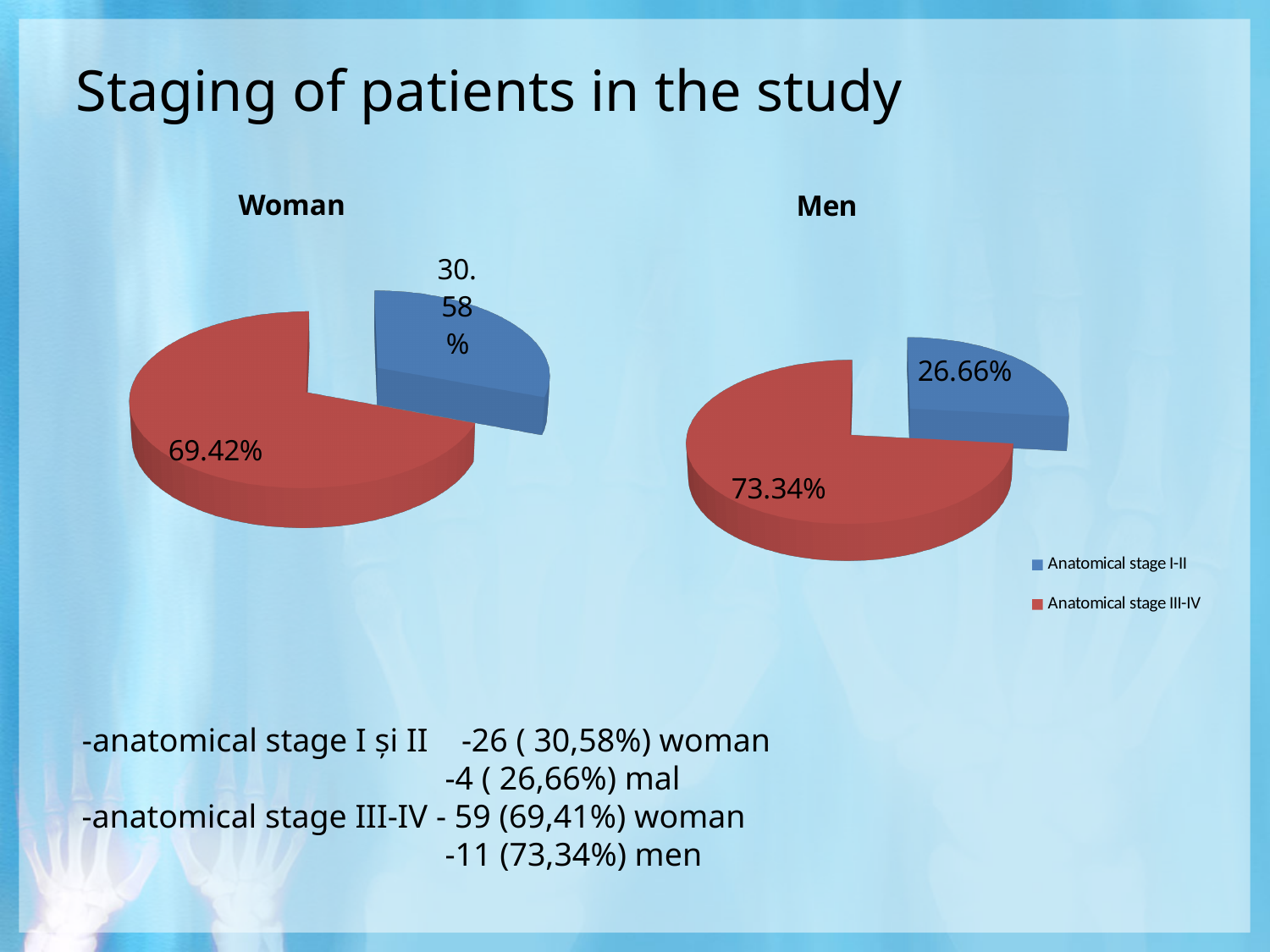
In the Men chart, what share of patients are in Anatomical stage III-IV? 73.34% How many entries does the legend list? 2 What colour represents Anatomical stage III-IV in the charts? Red In the Woman chart, which category has the smallest slice? Anatomical stage I-II In the Woman chart, what share of patients are in Anatomical stage III-IV? 69.42% Is the Anatomical stage I-II share larger in the Woman chart or the Men chart? Woman What kind of chart is the Men chart? Pie chart In the Woman chart, what share of patients are in Anatomical stage I-II? 30.58% In the Men chart, which category has the largest slice? Anatomical stage III-IV In the Woman chart, what is the difference between the Anatomical stage III-IV share and the Anatomical stage I-II share? 38.84% In the Men chart, what share of patients are in Anatomical stage I-II? 26.66% How many slices does the Woman chart have? 2